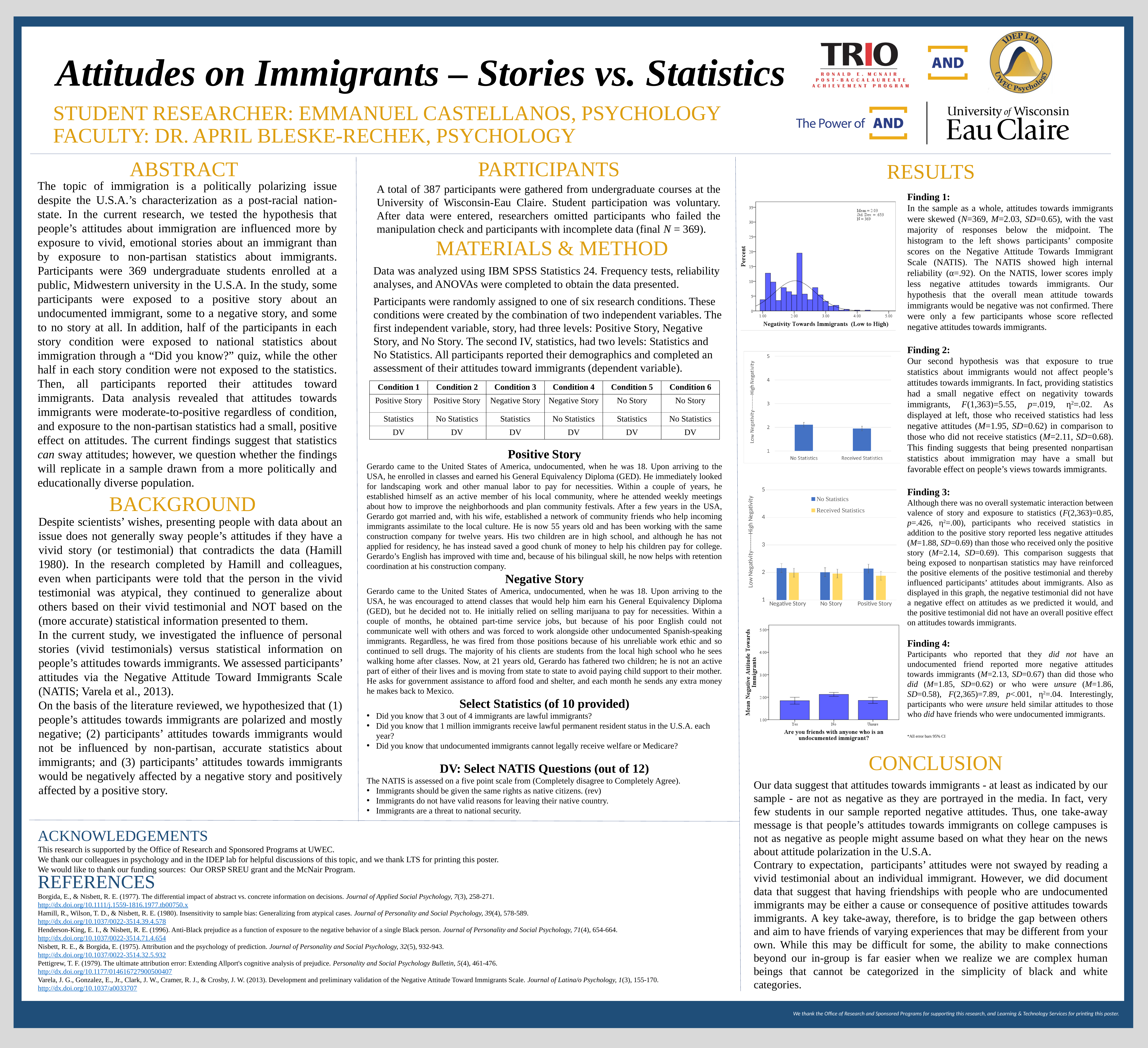
In the grouped bar chart with Negative Story, No Story and Positive Story, for Positive Story, which series has the taller bar: No Statistics or Received Statistics? No Statistics In the grouped bar chart with Negative Story, No Story and Positive Story, how many story categories are on the x axis? 3 In the grouped bar chart with Negative Story, No Story and Positive Story, is the No Statistics value for Negative Story greater or less than 4? less In the chart titled 'Are you friends with anyone who is an undocumented immigrant?', which category has the highest mean negative attitude? No In the grouped bar chart with Negative Story, No Story and Positive Story, what are the two legend entries? No Statistics, Received Statistics What is the x-axis label of the histogram at the top of the Results section? Negativity Towards Immigrants (Low to High) In the chart with categories No Statistics and Received Statistics, how many categories are shown? 2 In the chart titled 'Are you friends with anyone who is an undocumented immigrant?', how many response categories are shown? 3 In the grouped bar chart with Negative Story, No Story and Positive Story, how many series does the legend list? 2 In the chart with categories No Statistics and Received Statistics, is the value for No Statistics greater or less than 3? less What kind of chart is the chart with categories No Statistics and Received Statistics? bar chart In the chart with categories No Statistics and Received Statistics, which category has the taller bar? No Statistics